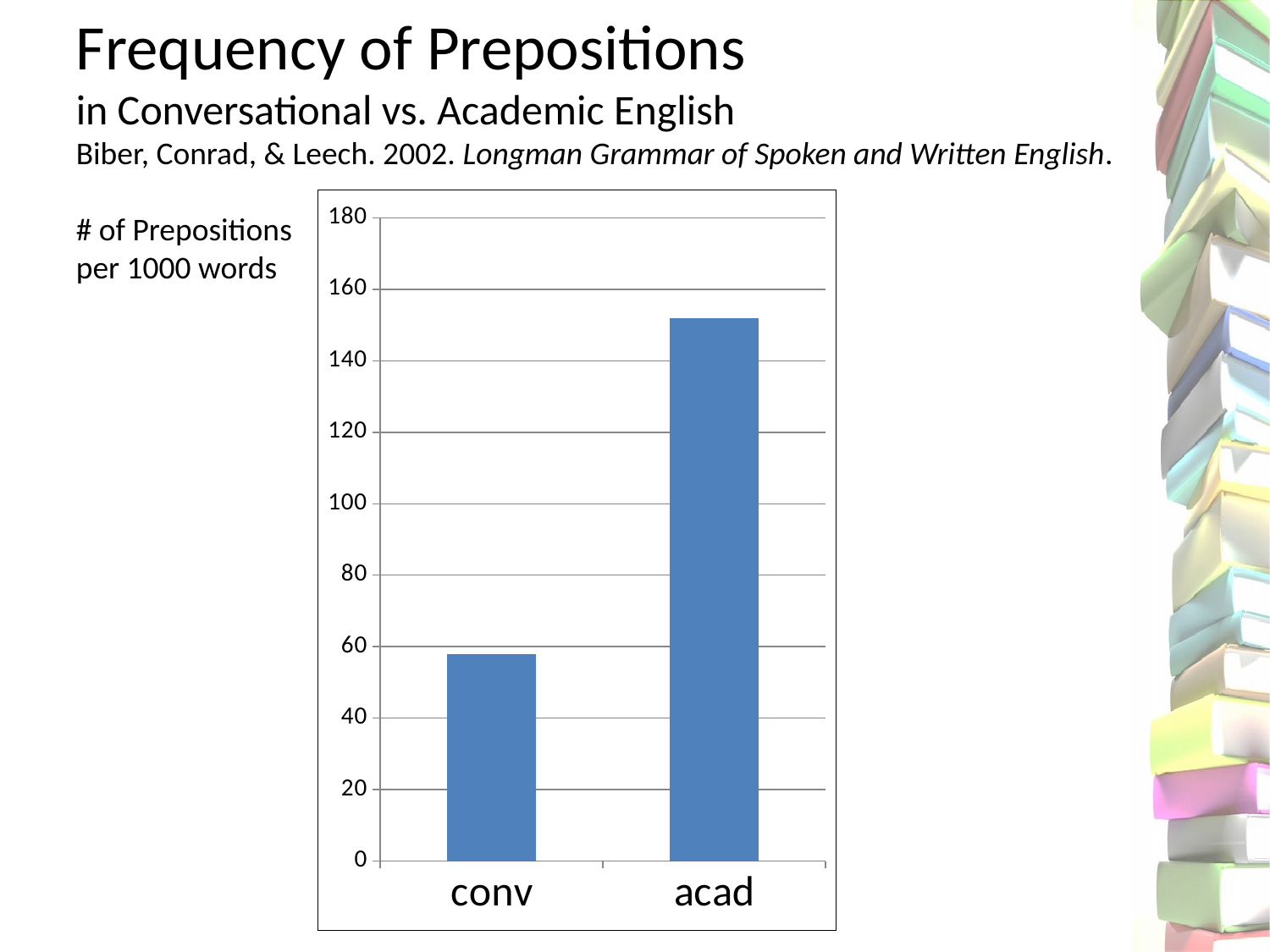
How many categories are plotted in the chart? 2 What is the highest value shown on the vertical axis of the chart? 180 What kind of chart is shown on the slide? bar chart What unit does the slide say the chart's values are measured in? # of Prepositions per 1000 words Which category has the highest value in the chart? acad Is the value for acad greater or less than 160? less Which category has the lowest value in the chart? conv Which is larger, the value for conv or the value for acad? acad Is the value for conv greater or less than 40? greater Is the value for conv greater or less than 60? less